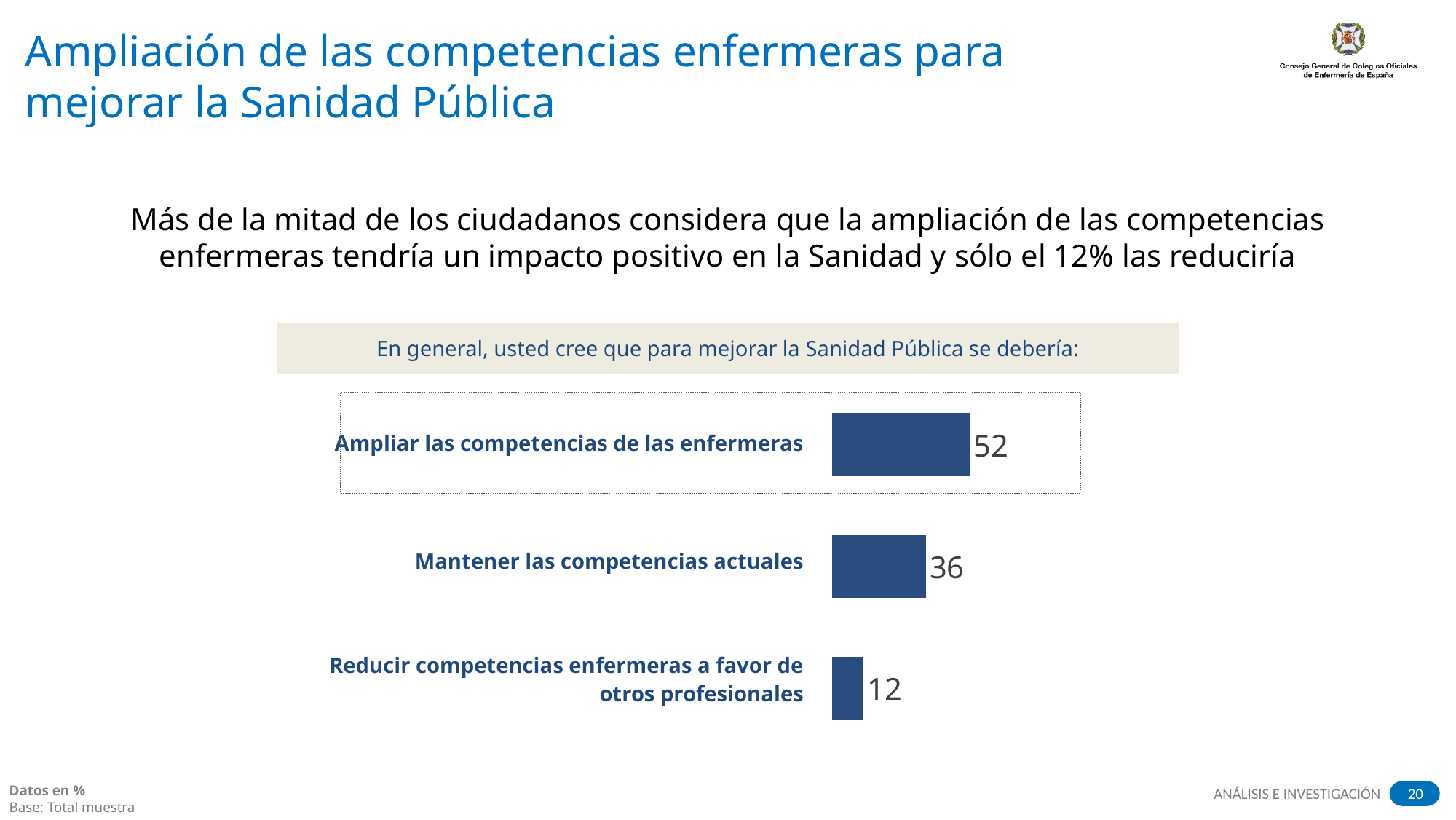
Which category has the lowest value? Reducir competencias enfermeras a favor de otros profesionales Which category has the highest value? Ampliar las competencias de las enfermeras How many categories are shown in the chart? 3 Which is larger: the value for "Mantener las competencias actuales" or for "Reducir competencias enfermeras a favor de otros profesionales"? Mantener las competencias actuales What is the value for "Mantener las competencias actuales"? 36 What is the difference between the values for "Ampliar las competencias de las enfermeras" and "Mantener las competencias actuales"? 16 What kind of chart is shown on the slide? Bar chart What question heading appears above the chart? En general, usted cree que para mejorar la Sanidad Pública se debería: What is the difference between the values for "Mantener las competencias actuales" and "Reducir competencias enfermeras a favor de otros profesionales"? 24 What is the value for "Ampliar las competencias de las enfermeras"? 52 What is the value for "Reducir competencias enfermeras a favor de otros profesionales"? 12 What is the total of the three values shown in the chart? 100